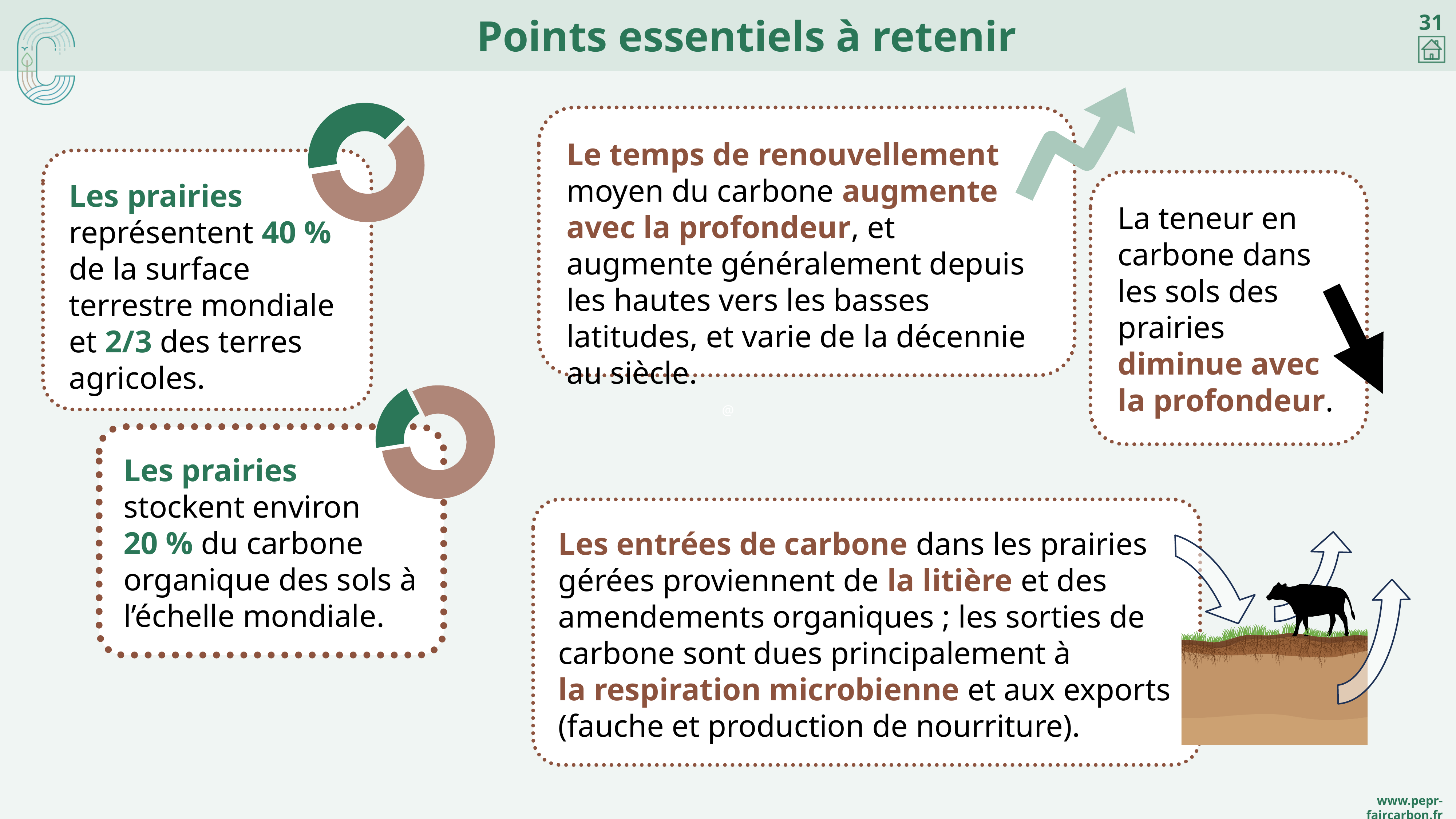
How many slices does the top donut chart (next to 'Les prairies représentent 40 %') have? 2 Which donut chart has the larger green slice, the top one or the bottom one? the top one How many donut charts are shown on the slide? 2 In the bottom donut chart, what share of the whole does the green slice represent, according to the accompanying text? 20 % What kind of chart is shown beside the text 'Les prairies représentent 40 %' on the left of the slide? donut chart In the top donut chart, which slice is larger, the green one or the brown one? the brown one In the bottom donut chart, which slice is larger, the green one or the brown one? the brown one How many slices does the bottom donut chart (next to 'Les prairies stockent environ 20 %') have? 2 In the top donut chart, what share of the whole does the green slice represent, according to the accompanying text? 40 % What colour is the smaller slice in both donut charts? green